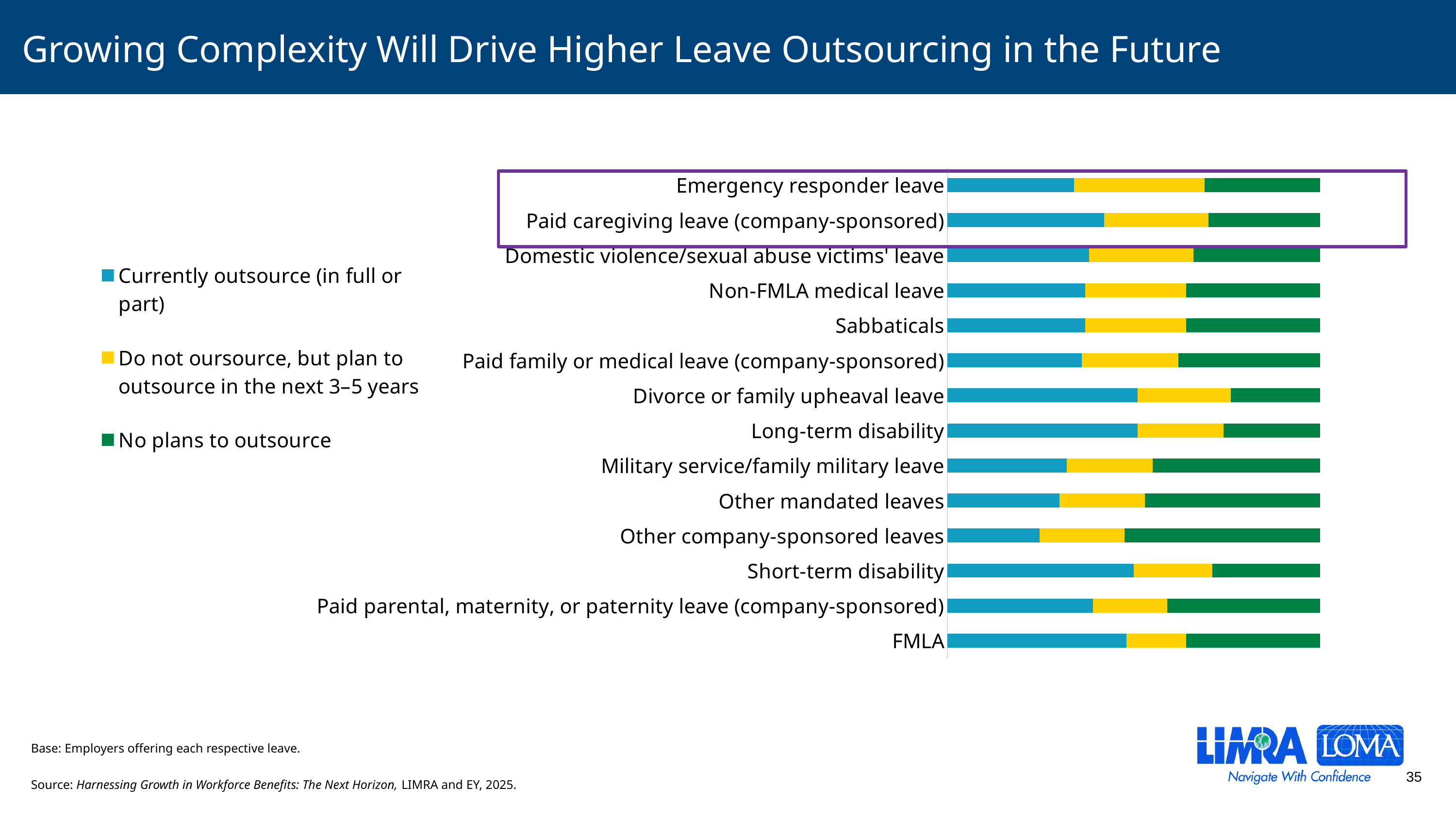
What kind of chart is shown on the slide? Stacked bar chart Which leave category has the smallest 'Currently outsource (in full or part)' segment? Other company-sponsored leaves How many leave categories are plotted in the chart? 14 Which leave category has the largest 'No plans to outsource' segment? Other company-sponsored leaves Which leave category has the largest 'Do not outsource, but plan to outsource in the next 3–5 years' segment? Emergency responder leave Which has a larger 'Do not outsource, but plan to outsource in the next 3–5 years' segment: Emergency responder leave or FMLA? Emergency responder leave Which has a larger 'Currently outsource (in full or part)' segment: FMLA or Other company-sponsored leaves? FMLA Which leave category has the smallest 'Do not outsource, but plan to outsource in the next 3–5 years' segment? FMLA Which two leave categories are highlighted with a purple box at the top of the chart? Emergency responder leave and Paid caregiving leave (company-sponsored) Which colour represents 'No plans to outsource' in the chart? Green Which has a larger 'No plans to outsource' segment: Other company-sponsored leaves or Long-term disability? Other company-sponsored leaves How many series does the legend list? 3